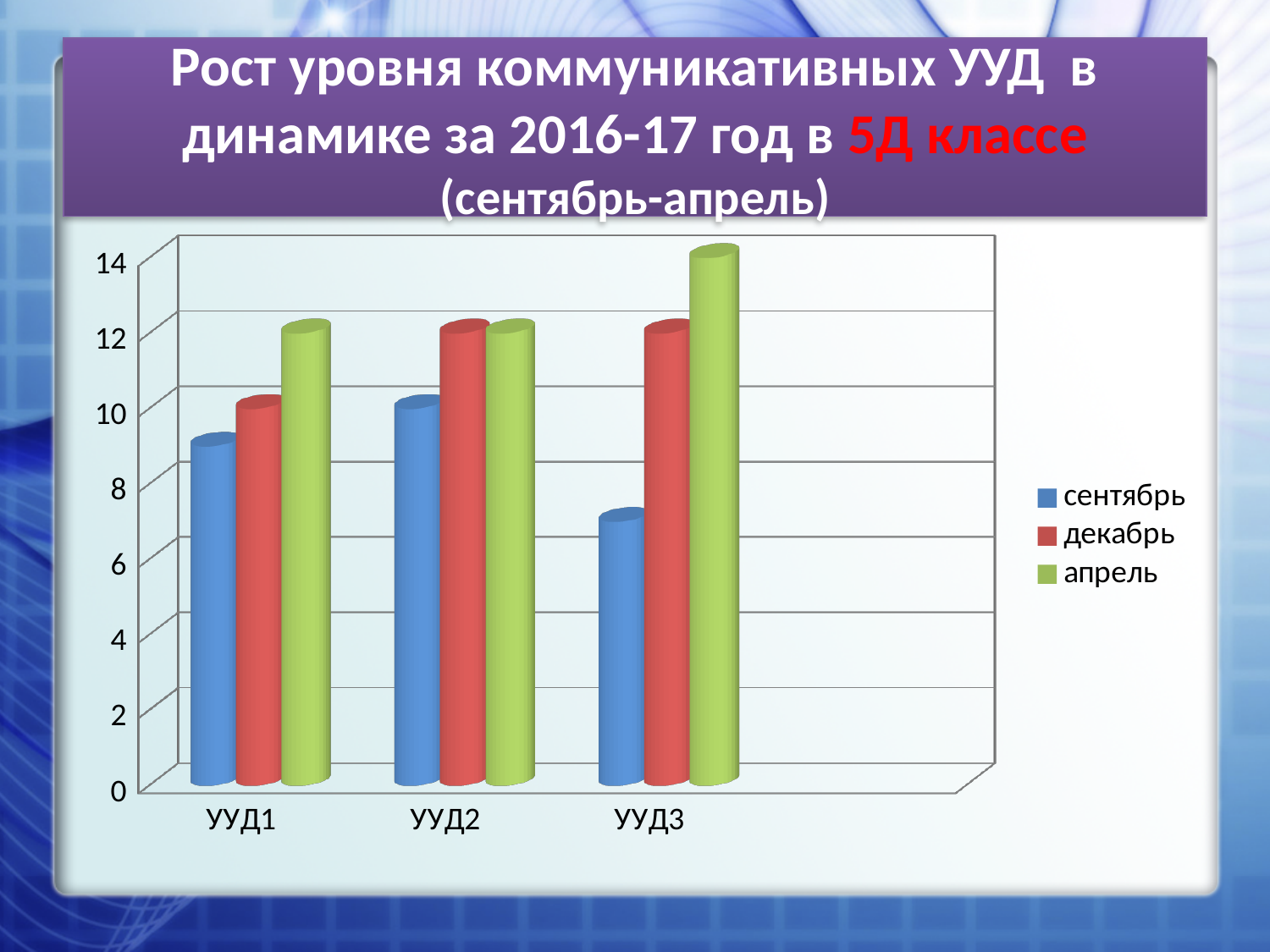
For УУД1, do the values rise or fall from сентябрь to апрель? rise Which series has the highest value for УУД3? апрель What kind of chart is shown on the slide? bar chart How many categories are shown on the x axis of the chart? 3 What colour are the апрель bars in the chart? green Which is larger for УУД1: the сентябрь value or the апрель value? апрель Which series has the lowest value for УУД3? сентябрь Is the сентябрь value for УУД3 greater or less than 8? less How many series does the chart legend list? 3 Is the апрель value for УУД3 greater or less than 12? greater Is the сентябрь value for УУД1 greater or less than 8? greater Which category has the lowest сентябрь value? УУД3